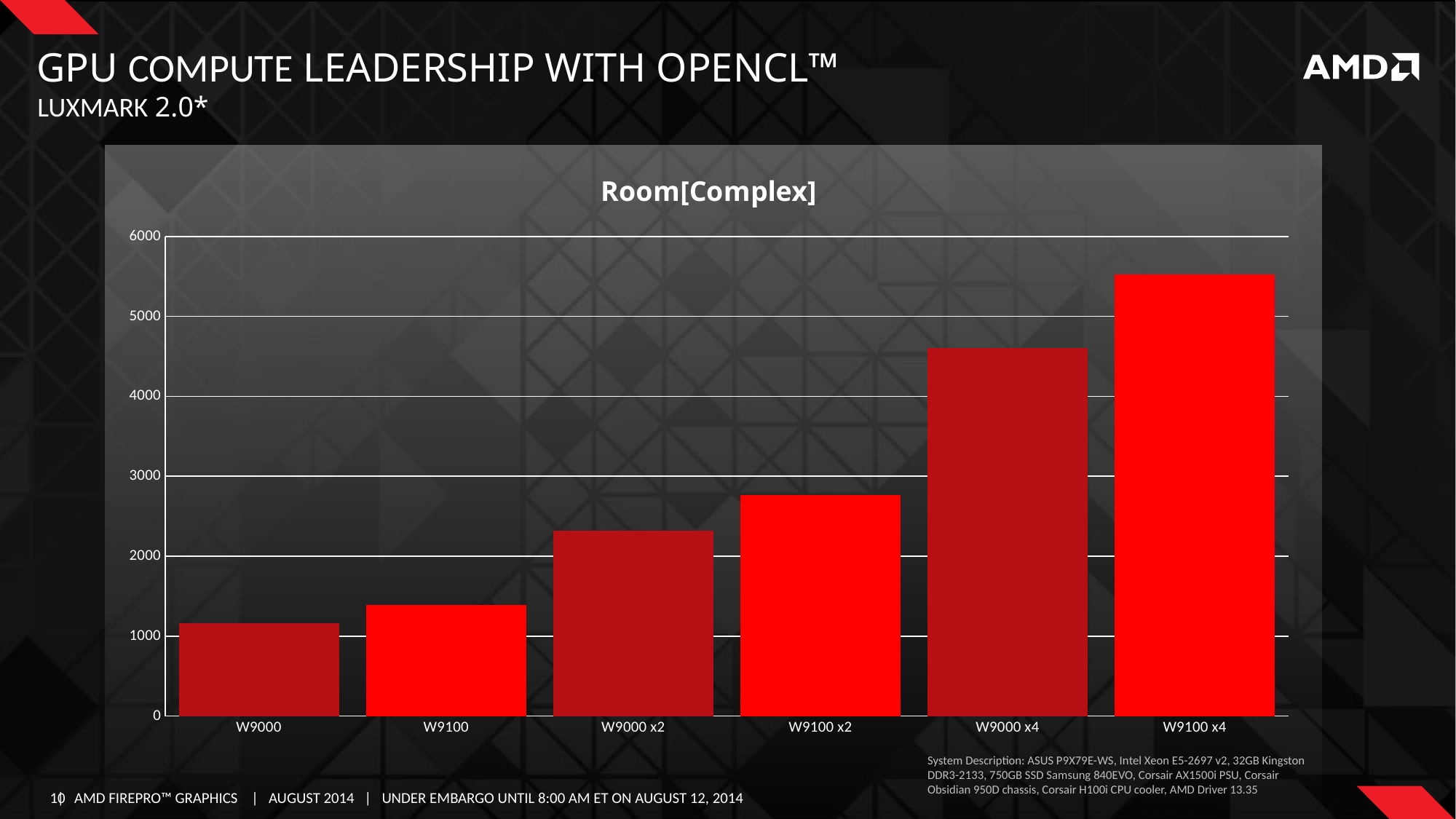
Is the value for W9000 greater or less than 1000? greater Is the value for W9100 x4 greater or less than 5000? greater Which category has the lowest value? W9000 Which category has the highest value? W9100 x4 Is the value for W9100 x2 greater or less than 3000? less How many categories are plotted on the x axis? 6 Which is larger, the value for W9100 x2 or the value for W9000 x2? W9100 x2 What is the title of the chart? Room[Complex] What kind of chart is shown on the slide? bar chart